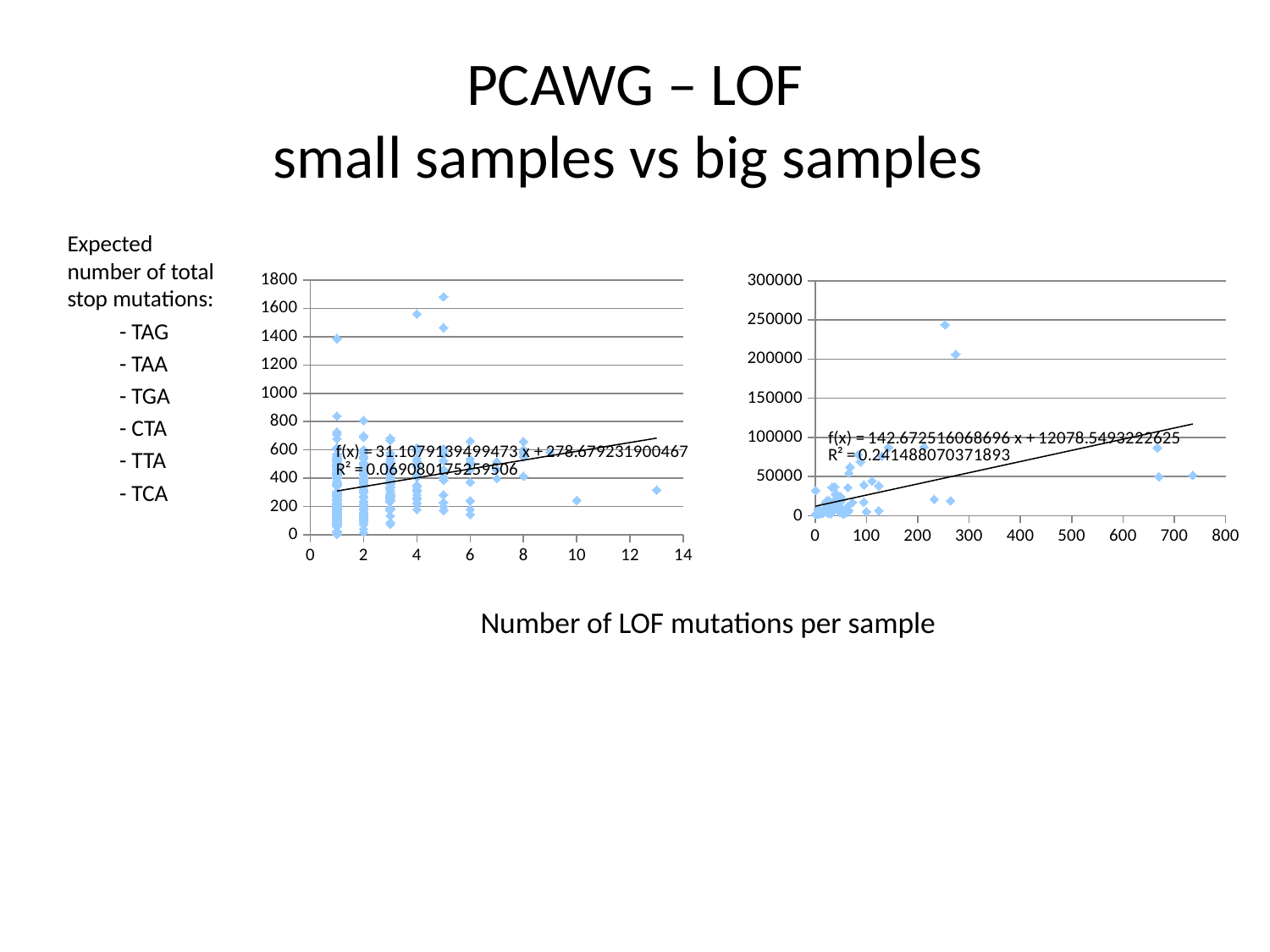
In the right chart, what is the highest value shown on the x axis? 800 In the right chart, what is the slope of the printed trendline equation f(x)? 142.672516068696 In the right chart, what is the intercept of the printed trendline equation f(x)? 12078.5493222625 What kind of chart is the left chart on the slide? scatter chart What kind of chart is the right chart on the slide? scatter chart In the left chart, does the fitted trendline rise or fall as x increases? rises In the right chart, does the fitted trendline rise or fall as x increases? rises In the right chart, what R² value is printed for the trendline? 0.241488070371893 In the left chart, what is the highest value shown on the y axis? 1800 In the left chart, is the y-value of the highest point greater or less than 1600? greater In the right chart, is the y-value of the highest point greater or less than 200000? greater In the right chart, is the y-value of the rightmost point (near x = 740) greater or less than 100000? less